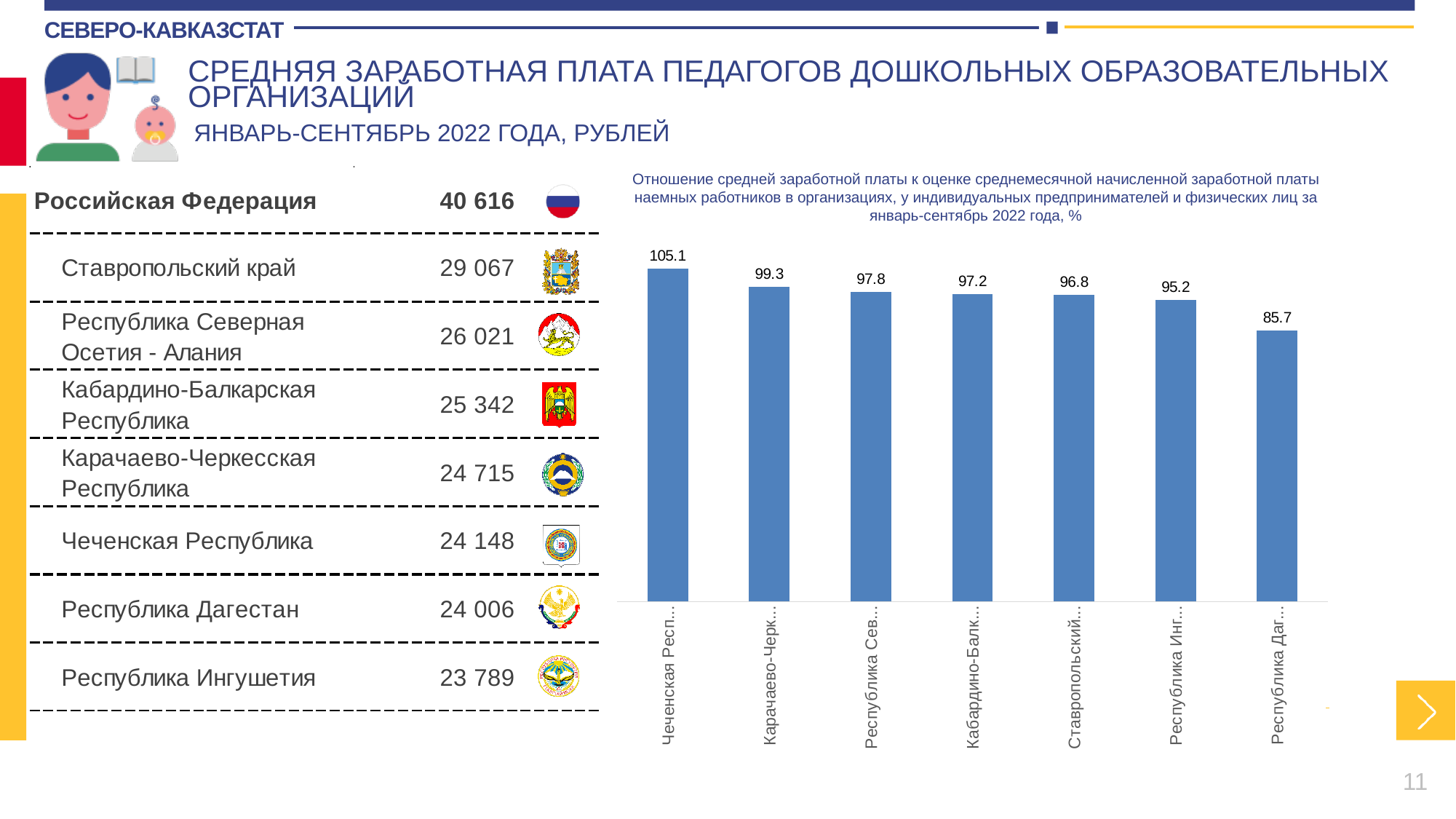
Which has a larger value: Карачаево-Черкесская Республика or Кабардино-Балкарская Республика? Карачаево-Черкесская Республика What unit is the chart's data expressed in, according to its title? % Which region has the highest value in the chart? Чеченская Республика What is the value for Республика Дагестан in the chart? 85.7 What is the value for Республика Ингушетия in the chart? 95.2 What type of chart is shown on the slide? bar chart Do the values rise or fall from left to right along the x axis? fall What is the difference between the values for Чеченская Республика and Республика Дагестан? 19.4 How many bars (regions) are plotted in the chart? 7 What is the value for Чеченская Республика in the chart? 105.1 Which region has the lowest value in the chart? Республика Дагестан What is the value for Ставропольский край in the chart? 96.8